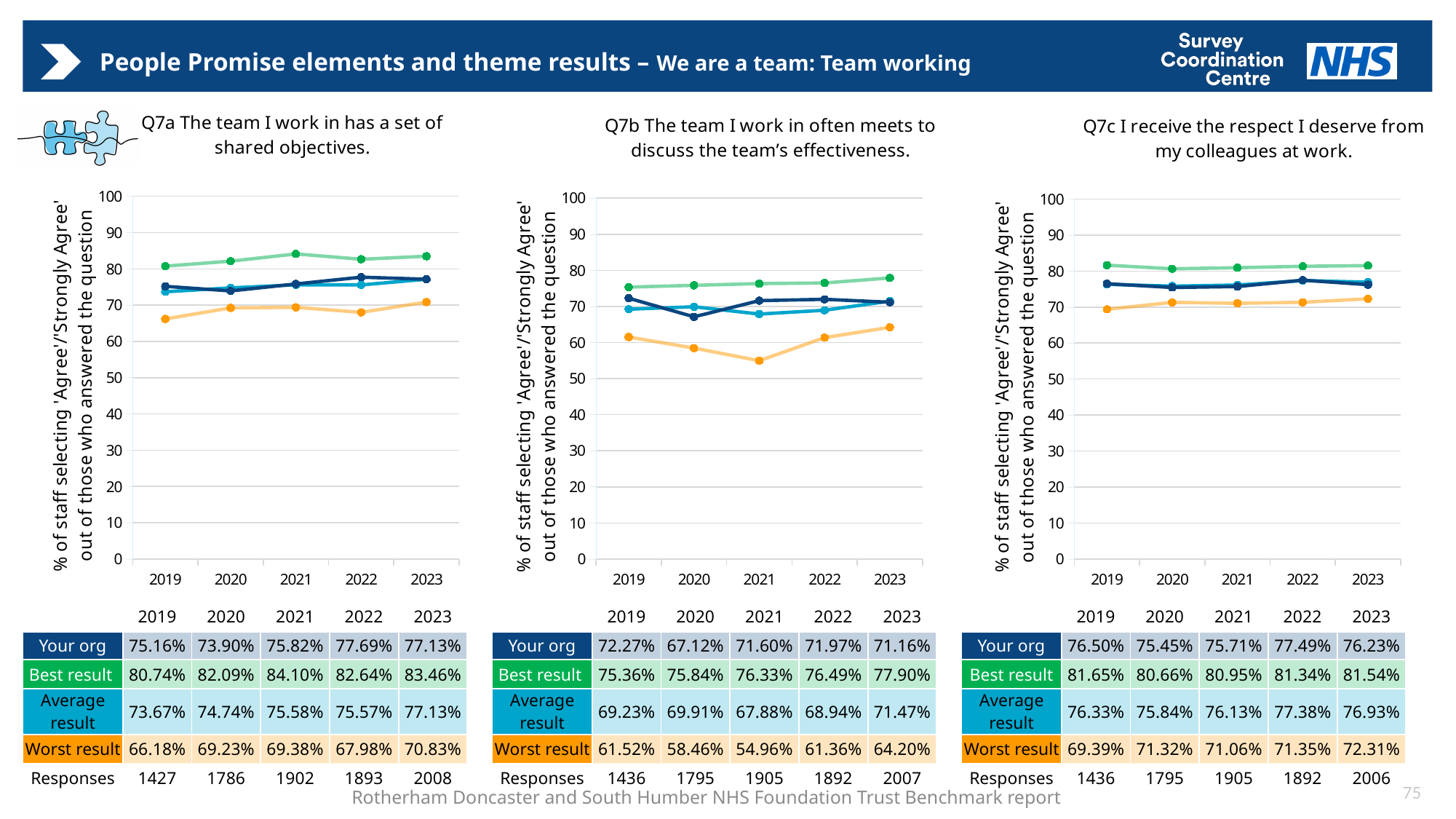
How many years are plotted on the x axis of the Q7c chart? 5 On the Q7c chart (I receive the respect I deserve from my colleagues at work), what was the 'Best result' value in 2023? 81.54% On the Q7c chart, what is the difference between the 'Best result' and 'Your org' values in 2019? 5.15% How many series are plotted on the Q7b chart? 4 On the Q7a chart, is the 'Worst result' value for 2019 greater or less than 70? less On the Q7a chart (The team I work in has a set of shared objectives), what was the 'Your org' value in 2022? 77.69% On the Q7b chart, did the 'Best result' series rise or fall from 2019 to 2023? Rise On the Q7b chart, in which year was the 'Your org' series lowest? 2020 On the Q7b chart (The team I work in often meets to discuss the team's effectiveness), what was the 'Worst result' value in 2021? 54.96% On the Q7b chart, which was larger in 2023: 'Your org' or 'Average result'? Average result What type of chart is used for Q7a? Line chart On the Q7a chart, in which year was the 'Best result' series highest? 2021